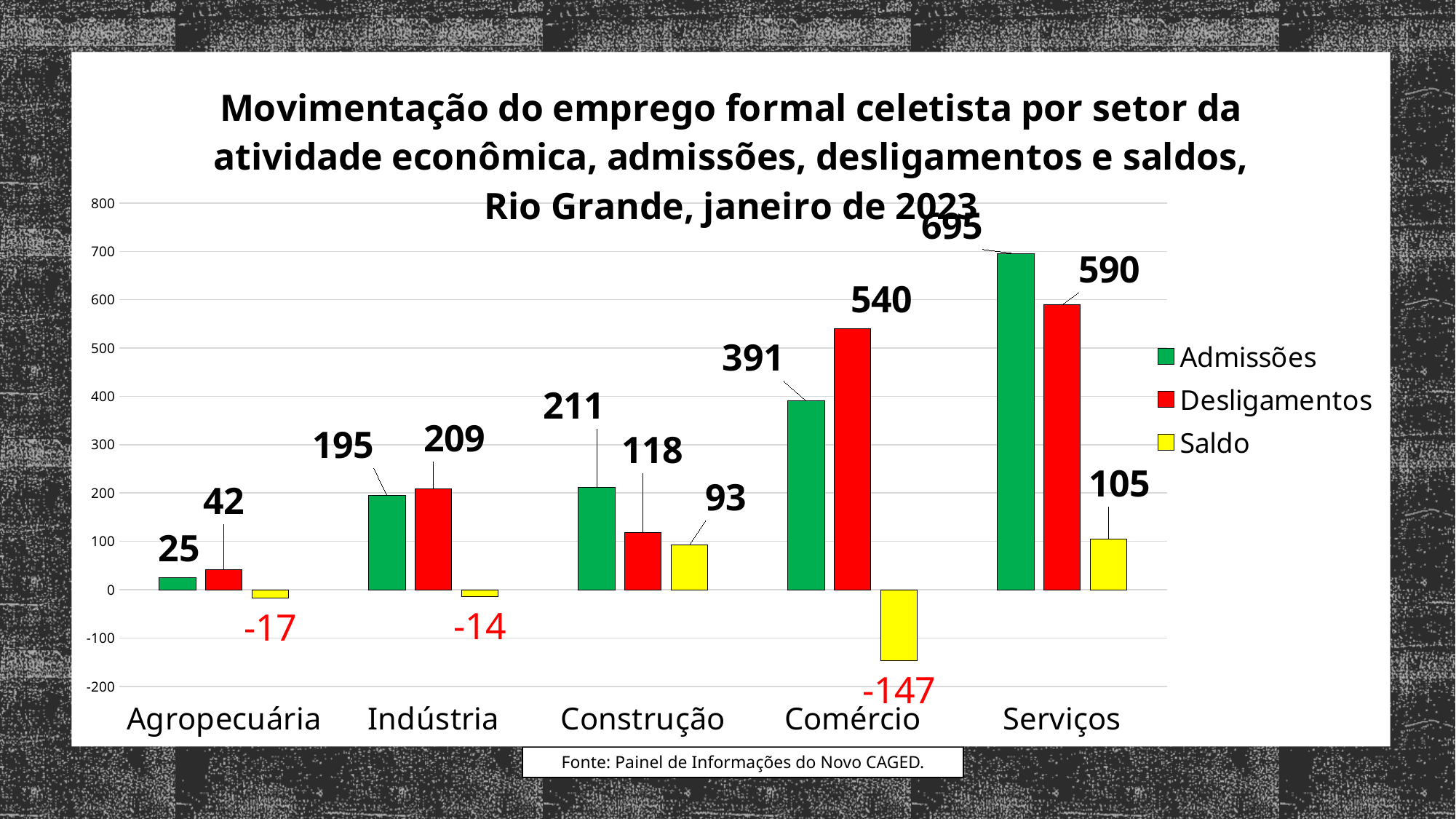
Which colour represents the Saldo series? Yellow How many sectors are shown on the x axis? 5 How many series does the legend list? 3 What is the value of Admissões for Comércio? 391 What is the Saldo value for Comércio? -147 What kind of chart is shown on the slide? Bar chart What is the value of Desligamentos for Indústria? 209 Which is larger for Construção: Admissões or Desligamentos? Admissões Which sector has the lowest Desligamentos value? Agropecuária Which sector has the highest Admissões value? Serviços Do the Admissões values rise or fall from Agropecuária to Serviços? Rise What is the difference between Admissões and Desligamentos for Serviços? 105